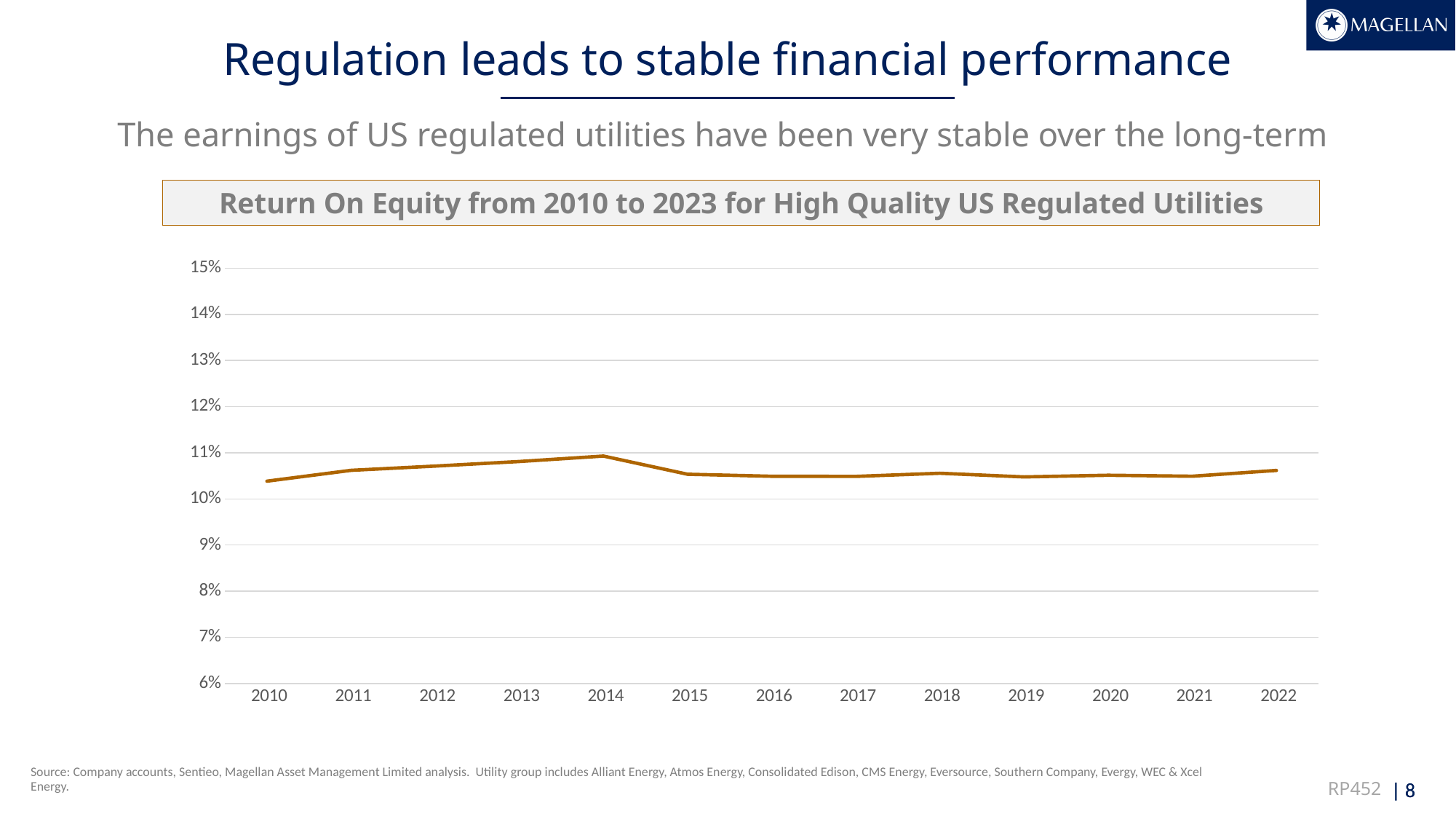
Is the return on equity for 2010 greater or less than 10%? greater Is the return on equity for 2016 greater or less than 11%? less What kind of chart is shown on the slide? line chart What is the first year shown on the x axis of the chart? 2010 Is the return on equity for 2022 greater or less than 12%? less How many years are plotted along the x axis of the chart? 13 Does the return on equity rise or fall from 2010 to 2014? rise Does the return on equity rise or fall from 2014 to 2015? fall Which year has the highest return on equity in the chart? 2014 Which year has the larger return on equity, 2014 or 2010? 2014 What is the title of the chart? Return On Equity from 2010 to 2023 for High Quality US Regulated Utilities